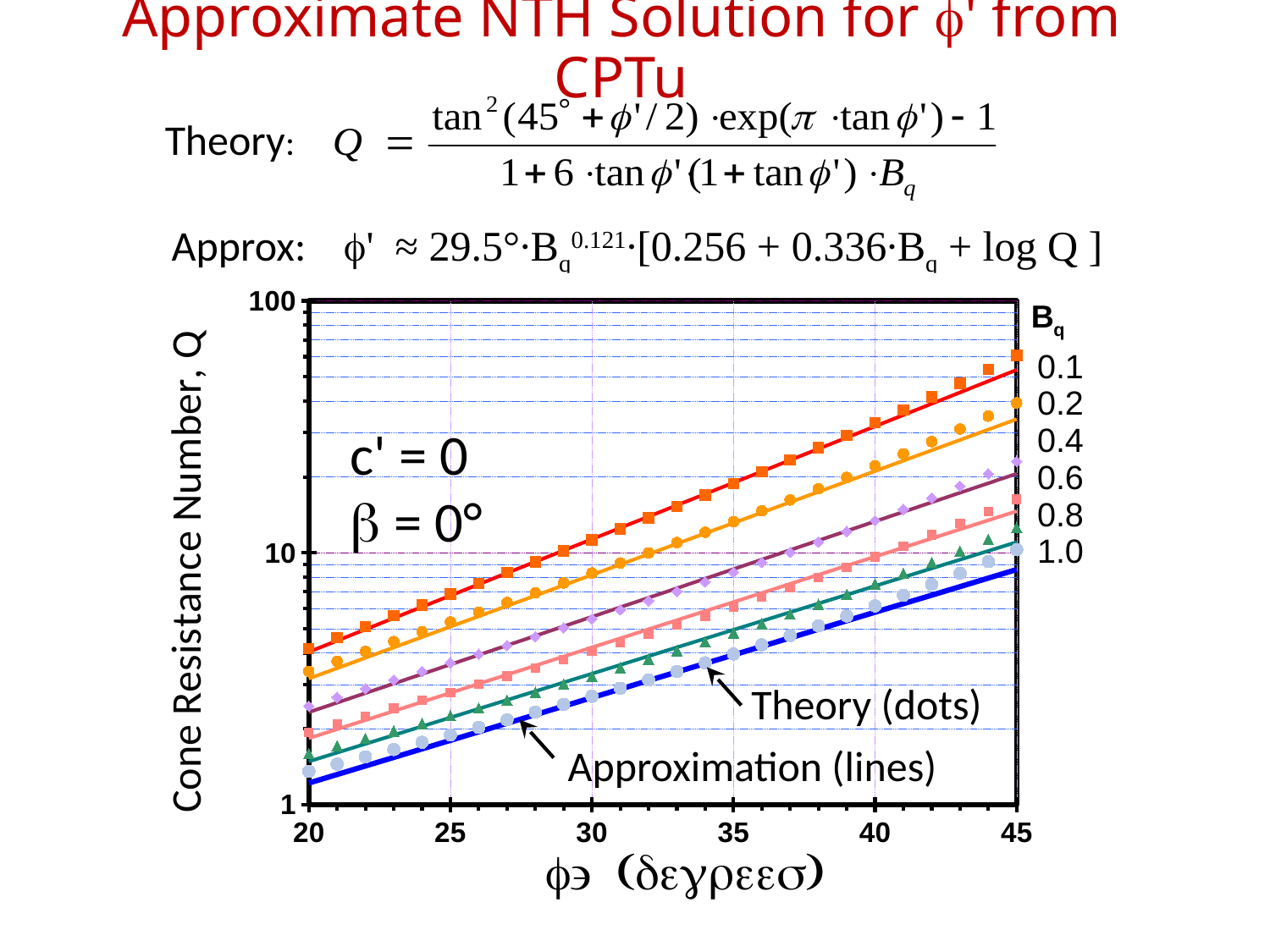
Is the value of Q for B_q = 0.1 at φ' = 45 degrees greater or less than 10? greater What kind of chart is shown on the slide? line chart Does Q rise or fall as φ' increases from 20 to 45 degrees? rise Which B_q series has the highest Q at φ' = 45 degrees? 0.1 How many B_q values (series) are labelled on the chart? 6 Is the value of Q for B_q = 0.1 at φ' = 35 degrees greater or less than 10? greater What is the label of the y-axis? Cone Resistance Number, Q What do the dots on the chart represent, according to the annotation? Theory At φ' = 30 degrees, which series has the larger Q: B_q = 0.1 or B_q = 1.0? B_q = 0.1 Which B_q series has the lowest Q at φ' = 45 degrees? 1.0 Is the value of Q for B_q = 1.0 at φ' = 20 degrees greater or less than 10? less